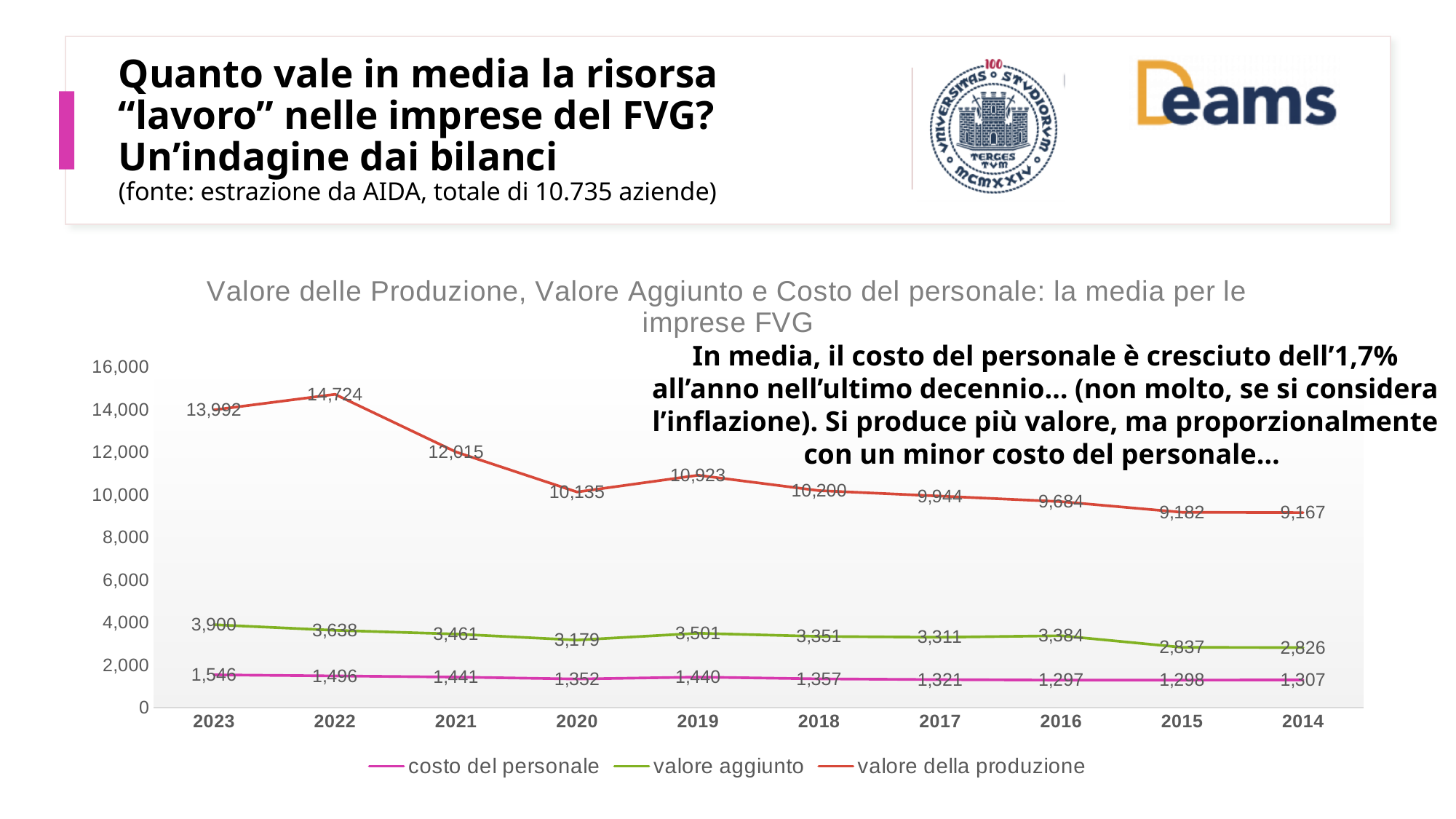
What is the value of 'valore della produzione' for 2022? 14,724 How many series does the legend list? 3 What is the value of 'costo del personale' for 2020? 1,352 How many years are shown on the x axis? 10 In which year is 'valore aggiunto' lowest? 2014 What kind of chart is shown on the slide? line chart Which is larger: 'costo del personale' in 2023 or in 2014? 2023 What is the difference between 'valore della produzione' in 2022 and in 2021? 2,709 Is the value for 'valore della produzione' in 2020 greater or less than 12,000? less What is the value of 'valore aggiunto' for 2019? 3,501 Which series is drawn in green in the chart? valore aggiunto In which year is 'valore della produzione' highest? 2022